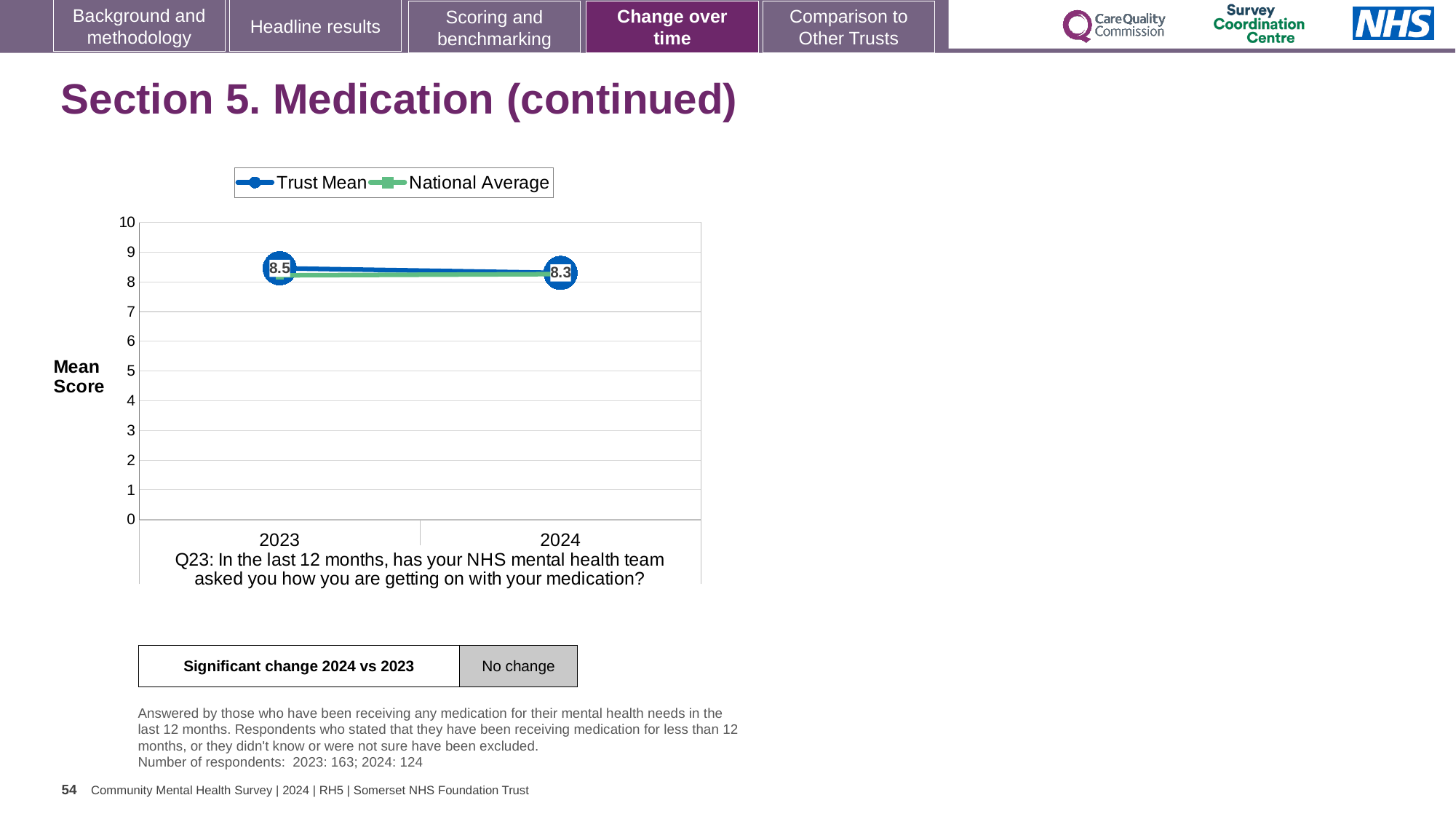
Does the Trust Mean score rise or fall from 2023 to 2024? fall Which is larger, the Trust Mean score for 2023 or for 2024? 2023 In which year is the Trust Mean score highest? 2023 What is the Trust Mean score for 2023? 8.5 What kind of chart is shown on the slide? line chart Is the National Average value for 2024 greater or less than 5? greater How many years are shown on the x axis of the chart? 2 What is the difference between the Trust Mean score in 2023 and in 2024? 0.2 How many series does the chart legend list? 2 In which year is the Trust Mean score lowest? 2024 Is the National Average value for 2023 greater or less than 7? greater What is the Trust Mean score for 2024? 8.3